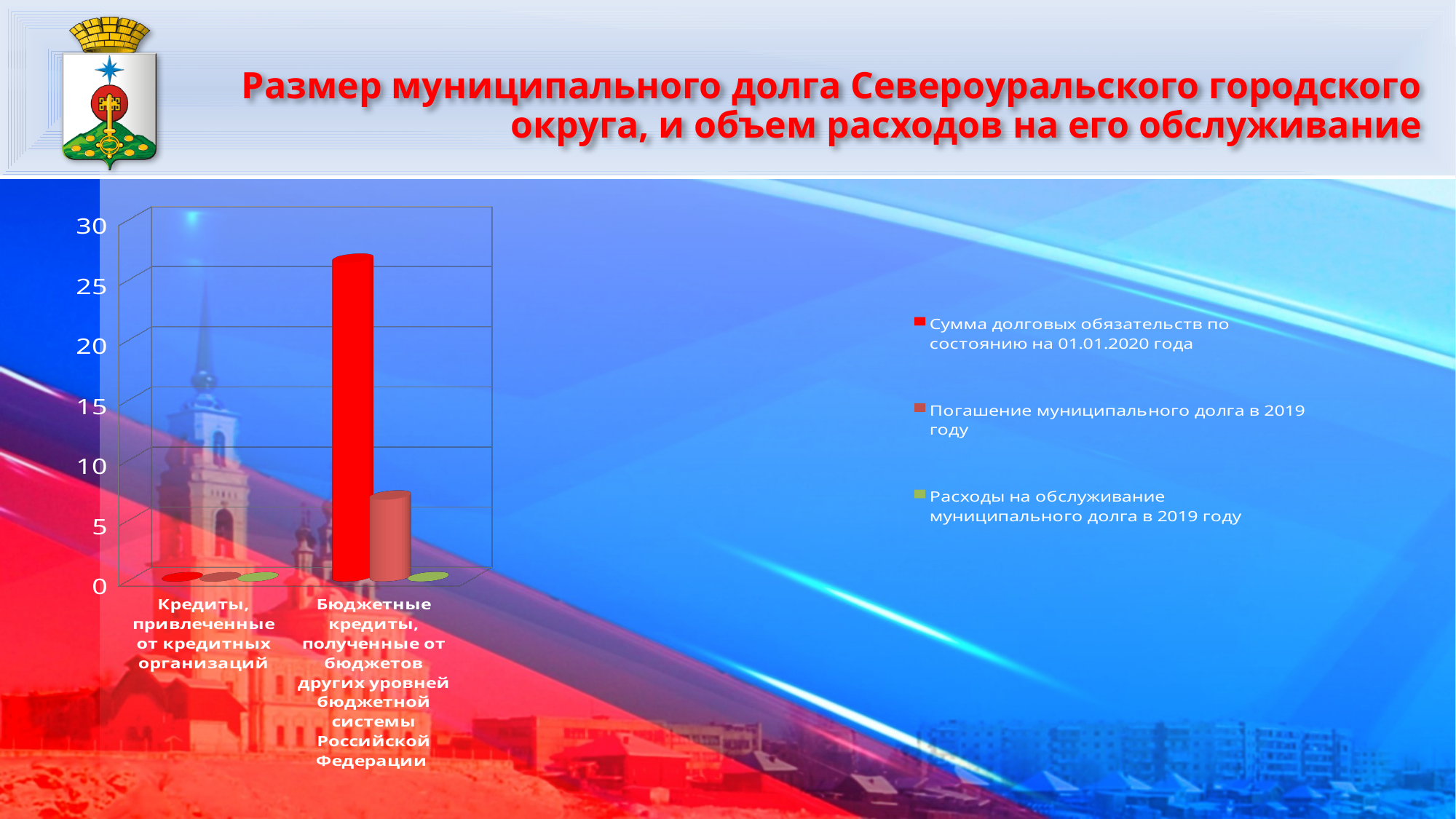
Is the value of "Сумма долговых обязательств по состоянию на 01.01.2020 года" for "Кредиты, привлеченные от кредитных организаций" greater or less than 5? less For "Бюджетные кредиты, полученные от бюджетов других уровней бюджетной системы Российской Федерации", which is larger: "Сумма долговых обязательств по состоянию на 01.01.2020 года" or "Погашение муниципального долга в 2019 году"? Сумма долговых обязательств по состоянию на 01.01.2020 года How many series does the chart legend list? 3 Which category has the lowest value for "Погашение муниципального долга в 2019 году"? Кредиты, привлеченные от кредитных организаций What is the highest tick value shown on the vertical axis of the chart? 30 Which series in the legend is shown in green? Расходы на обслуживание муниципального долга в 2019 году Is the value of "Сумма долговых обязательств по состоянию на 01.01.2020 года" for "Бюджетные кредиты, полученные от бюджетов других уровней бюджетной системы Российской Федерации" greater or less than 25? greater Is the value of "Погашение муниципального долга в 2019 году" for "Бюджетные кредиты, полученные от бюджетов других уровней бюджетной системы Российской Федерации" greater or less than 10? less How many categories are shown on the x axis of the chart? 2 What kind of chart is shown on the slide? bar chart Which category has the highest value for "Сумма долговых обязательств по состоянию на 01.01.2020 года"? Бюджетные кредиты, полученные от бюджетов других уровней бюджетной системы Российской Федерации